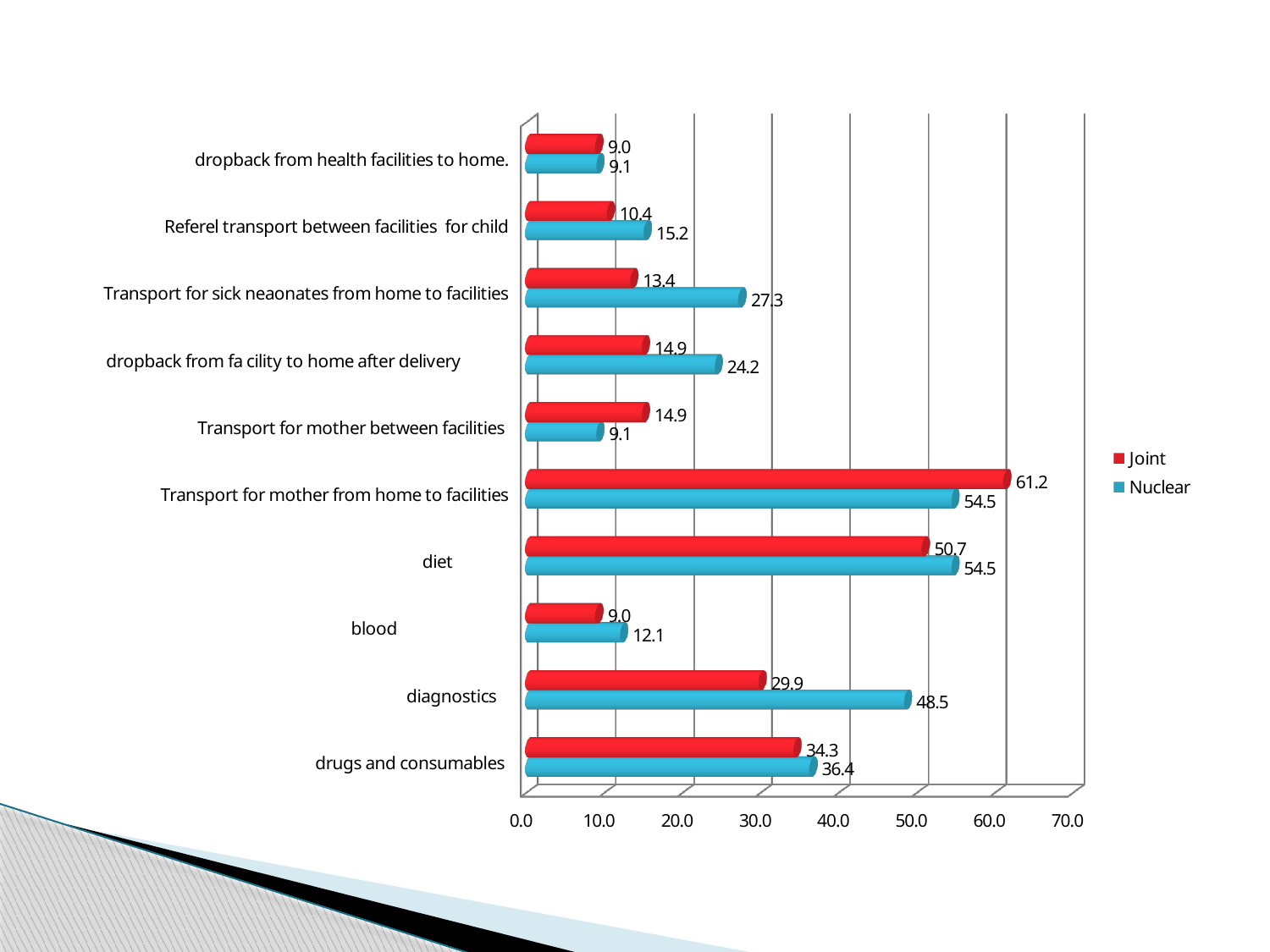
How many categories are shown on the chart? 10 What is the Nuclear value for diet? 54.5 Which colour represents the Nuclear series? blue What is the Joint value for diagnostics? 29.9 Which category has the lowest Nuclear value? dropback from health facilities to home. and Transport for mother between facilities (both 9.1) What is the difference between the Nuclear and Joint values for diagnostics? 18.6 Which is larger for diet, the Joint value or the Nuclear value? Nuclear What kind of chart is shown on the slide? bar chart How many series does the legend list? 2 Which category has the highest Joint value? Transport for mother from home to facilities What is the Nuclear value for Transport for sick neaonates from home to facilities? 27.3 Is the Joint value for Transport for mother from home to facilities greater or less than 60.0? greater